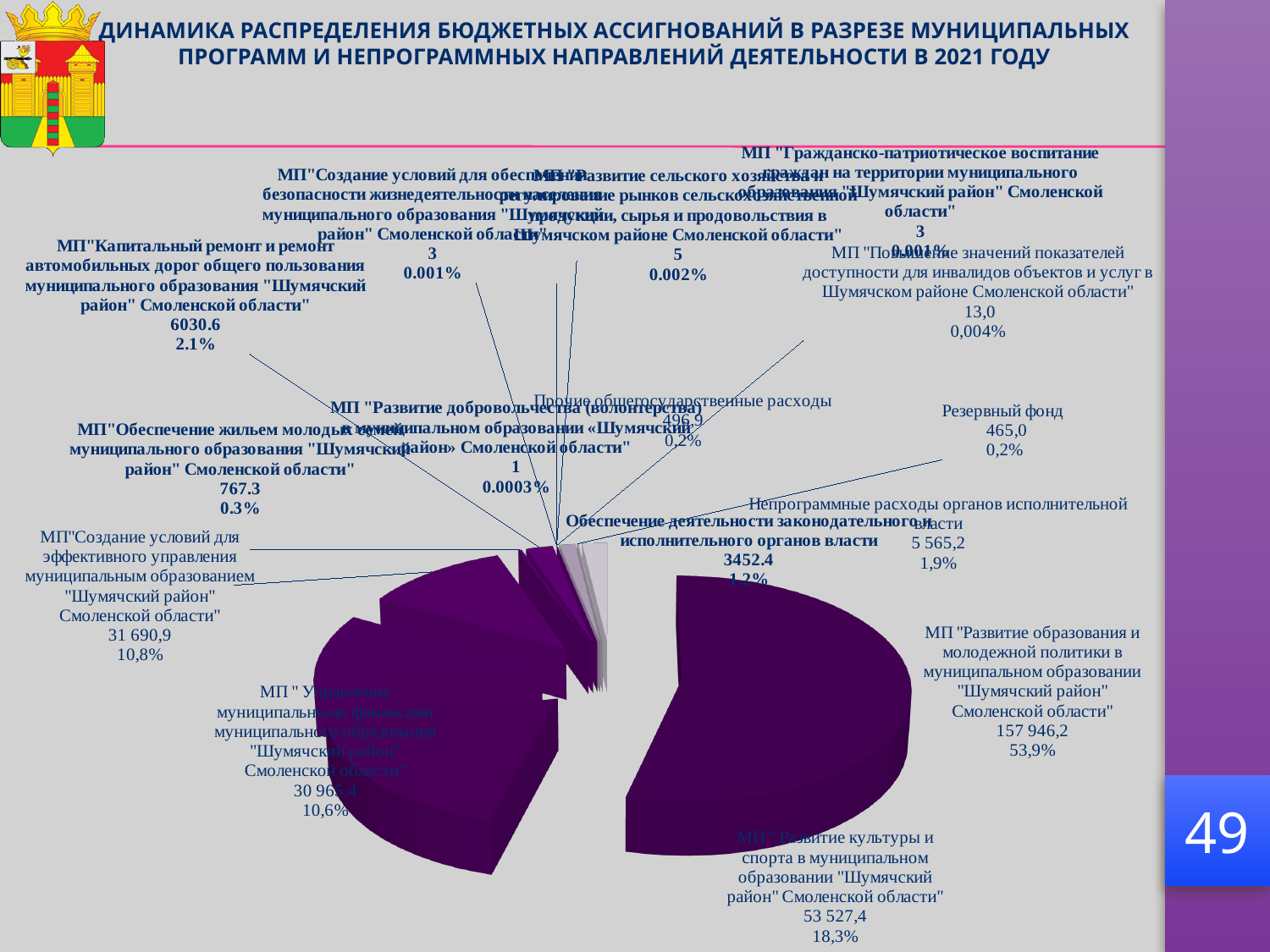
What kind of chart is shown on the slide? Pie chart What percentage is shown for МП "Создание условий для эффективного управления муниципальным образованием"? 10,8% What is the value shown for МП "Капитальный ремонт и ремонт автомобильных дорог общего пользования"? 6030.6 Which category has the largest share of the pie? МП "Развитие образования и молодежной политики" What is the value shown for Резервный фонд? 465,0 Which category has the smallest share of the pie? МП "Развитие добровольчества (волонтерства)" What is the value shown for МП "Развитие культуры и спорта"? 53 527,4 What is the value shown for Непрограммные расходы органов исполнительной власти? 5 565,2 Which is larger: the share for МП "Развитие культуры и спорта" or for МП "Создание условий для эффективного управления"? МП "Развитие культуры и спорта" What is the difference in percentage points between the share for МП "Развитие образования и молодежной политики" (53,9%) and МП "Развитие культуры и спорта" (18,3%)? 35,6 What percentage is shown for Обеспечение деятельности законодательного и исполнительного органов власти? 1.2% What share of the budget goes to МП "Развитие образования и молодежной политики"? 53,9%